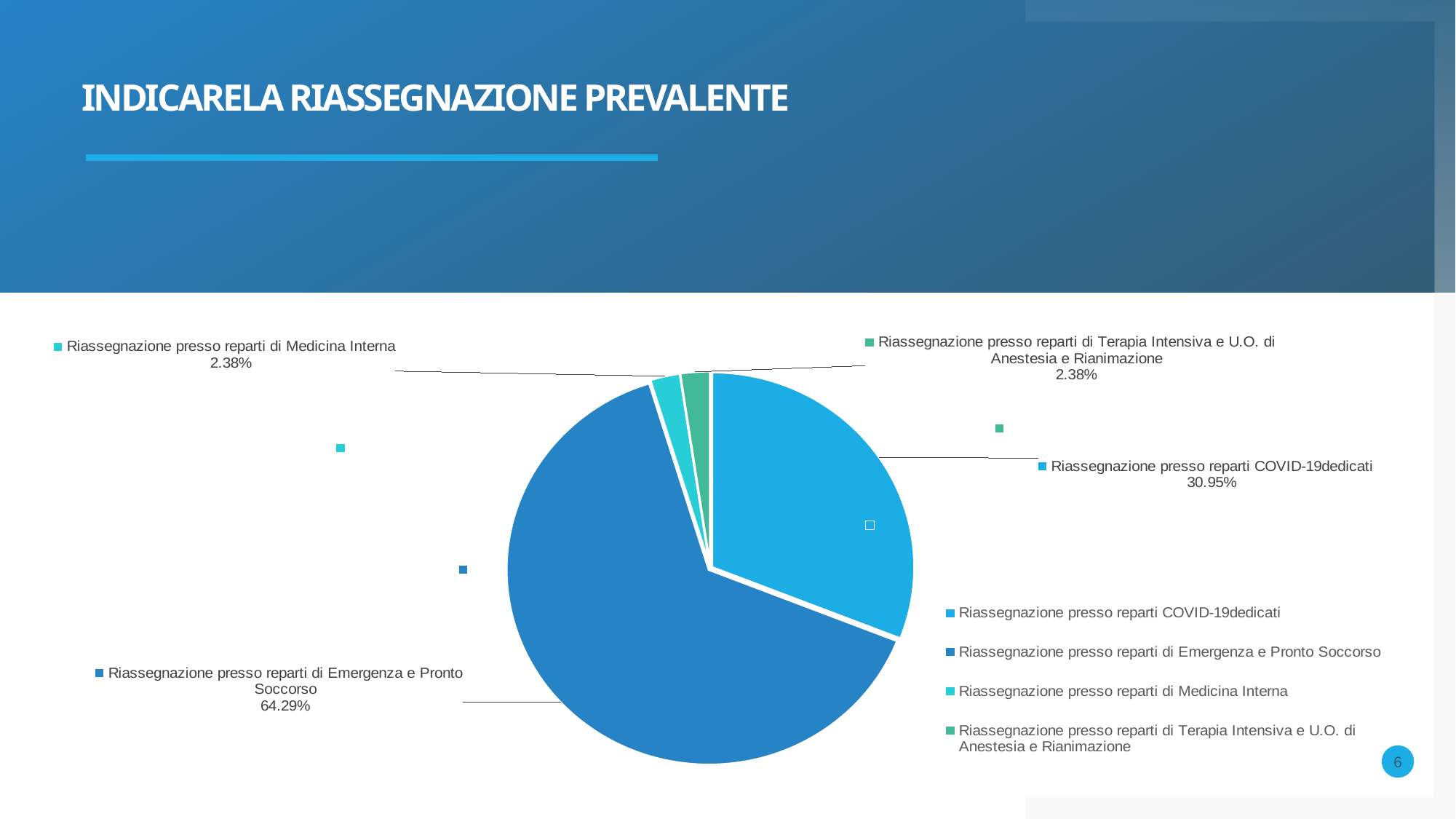
How many slices does the pie chart have? 4 Which category has the largest slice of the pie? Riassegnazione presso reparti di Emergenza e Pronto Soccorso What share of the pie is 'Riassegnazione presso reparti di Terapia Intensiva e U.O. di Anestesia e Rianimazione'? 2.38% What share of the pie is 'Riassegnazione presso reparti di Medicina Interna'? 2.38% What is the difference in percentage points between 'Emergenza e Pronto Soccorso' and 'COVID-19 dedicati'? 33.34% What share of the pie is 'Riassegnazione presso reparti di Emergenza e Pronto Soccorso'? 64.29% What is the title of the slide containing the pie chart? INDICARE LA RIASSEGNAZIONE PREVALENTE How many entries does the legend list? 4 What is the difference in percentage points between 'COVID-19 dedicati' and 'Medicina Interna'? 28.57% What type of chart is shown on the slide? pie chart Which is larger: the slice for 'COVID-19 dedicati' or the slice for 'Medicina Interna'? Riassegnazione presso reparti COVID-19 dedicati What share of the pie is 'Riassegnazione presso reparti COVID-19 dedicati'? 30.95%